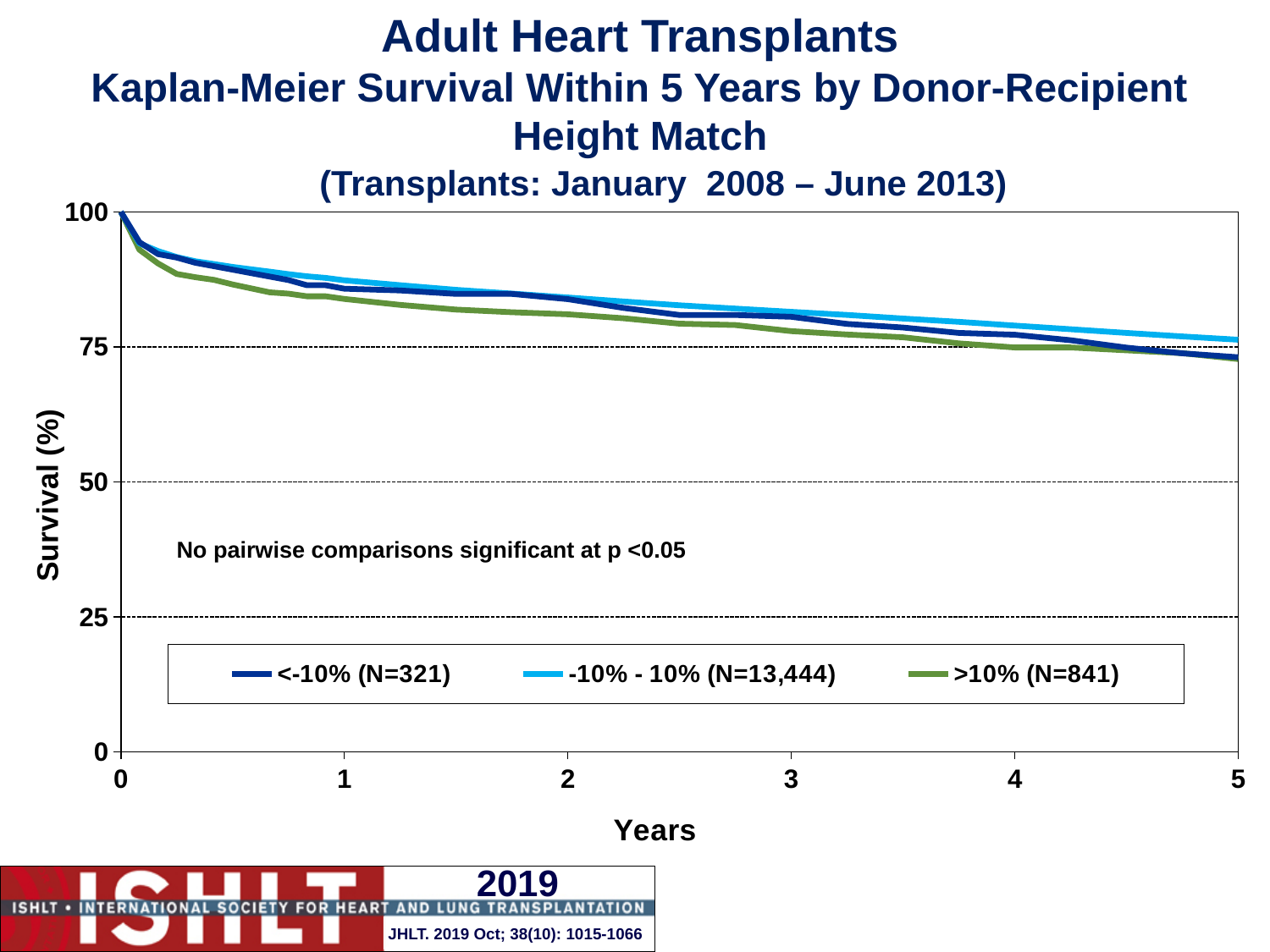
What is the N for the <-10% group shown in the legend? 321 Is the survival value for the >10% group at year 1 greater or less than 75? greater Is the survival value for the >10% group at year 3 greater or less than 50? greater How many series does the legend list? 3 What kind of chart is shown on the slide? line chart What is the N for the -10% - 10% group shown in the legend? 13,444 Do the survival curves rise or fall as years increase? fall What is the label of the y-axis? Survival (%) Is the survival value for the <-10% group at year 2 greater or less than 75? greater What does the annotation inside the chart say about pairwise comparisons? No pairwise comparisons significant at p <0.05 What is the N for the >10% group shown in the legend? 841